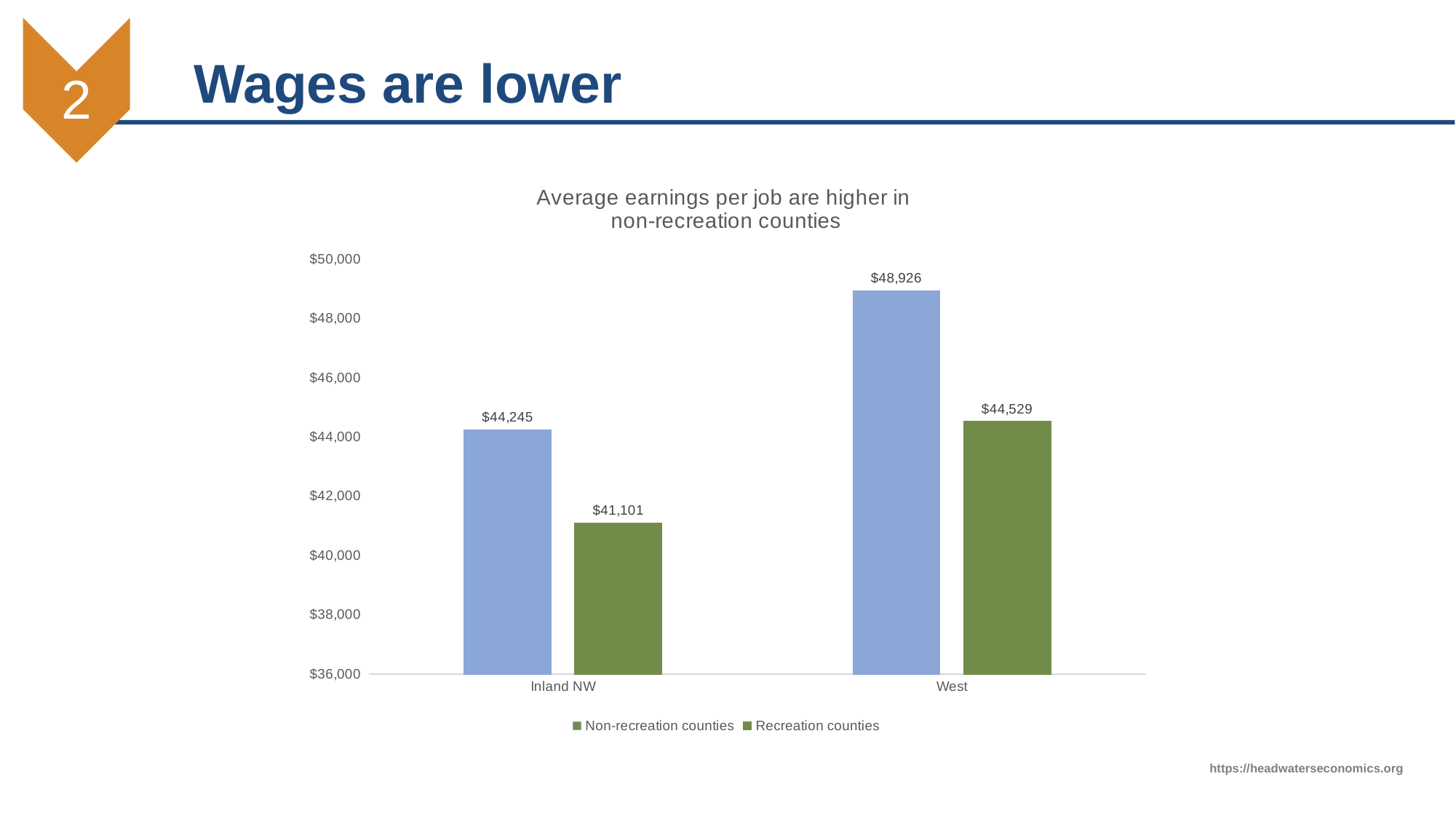
What is the difference between Non-recreation counties and Recreation counties in the West? $4,397 What is the value for Recreation counties in the West? $44,529 Which bar has the highest value on the chart? Non-recreation counties, West How many series does the legend list? 2 What is the title of the chart? Average earnings per job are higher in non-recreation counties What is the value for Recreation counties in Inland NW? $41,101 What is the value for Non-recreation counties in Inland NW? $44,245 What kind of chart is shown on the slide? Bar chart What is the value for Non-recreation counties in the West? $48,926 Which is larger: Recreation counties in the West or Non-recreation counties in Inland NW? Recreation counties in the West Which bar has the lowest value on the chart? Recreation counties, Inland NW What is the difference between Non-recreation counties and Recreation counties in Inland NW? $3,144